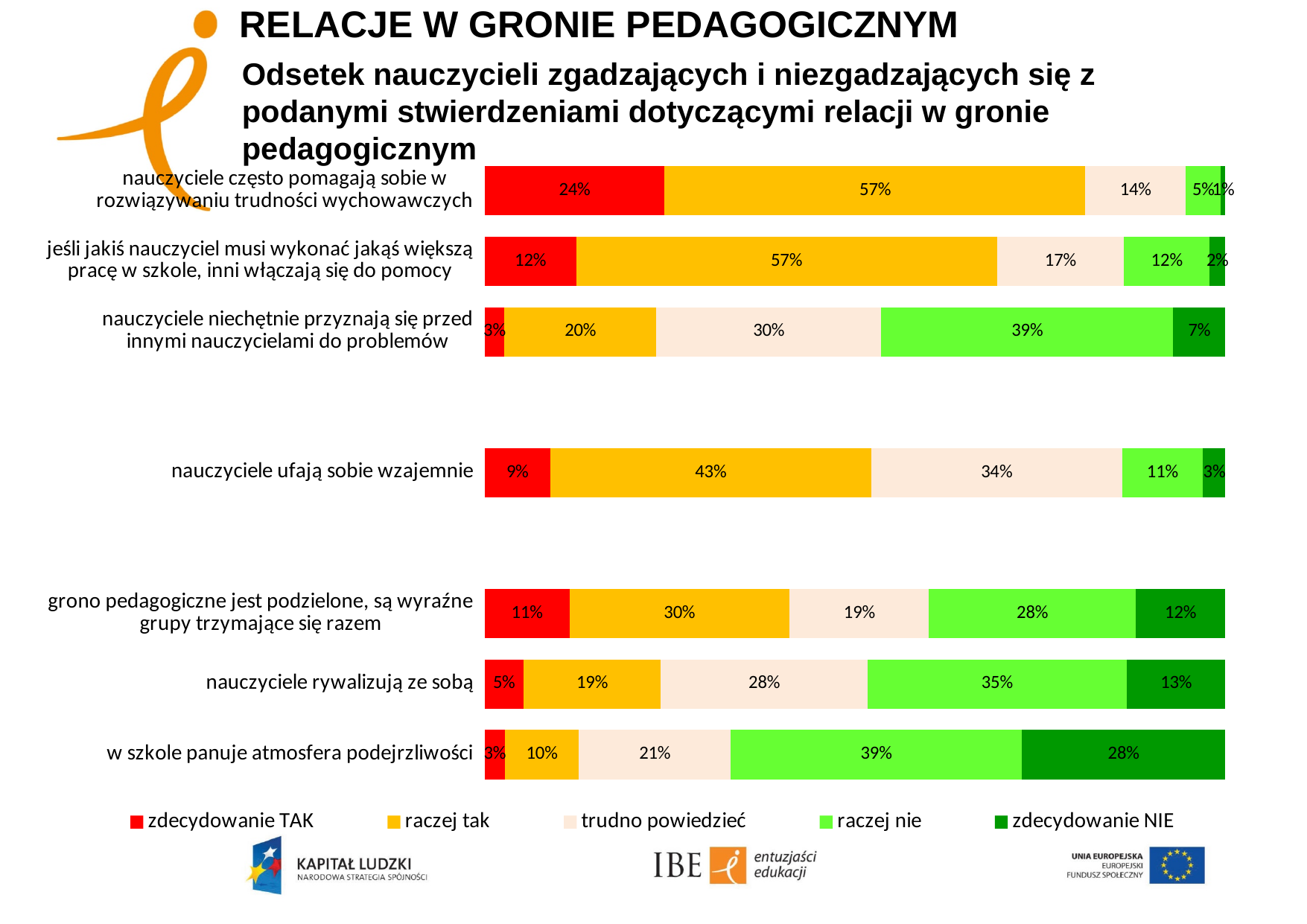
What kind of chart is shown on the slide? stacked bar chart Which statement has the lowest 'raczej tak' value? w szkole panuje atmosfera podejrzliwości Which statement has the highest 'zdecydowanie NIE' value? w szkole panuje atmosfera podejrzliwości How many series does the legend list? 5 What is the 'raczej nie' value for 'nauczyciele rywalizują ze sobą'? 35% What colour represents the 'zdecydowanie TAK' series in the legend? red What is the 'zdecydowanie NIE' value for 'w szkole panuje atmosfera podejrzliwości'? 28% How many statements (categories) are plotted in the chart? 7 What is the difference between the 'raczej tak' value and the 'zdecydowanie TAK' value for 'nauczyciele ufają sobie wzajemnie'? 34% What is the 'trudno powiedzieć' value for 'nauczyciele ufają sobie wzajemnie'? 34% Which is larger for 'grono pedagogiczne jest podzielone, są wyraźne grupy trzymające się razem': the 'raczej tak' value or the 'raczej nie' value? raczej tak What is the 'zdecydowanie TAK' value for 'nauczyciele często pomagają sobie w rozwiązywaniu trudności wychowawczych'? 24%